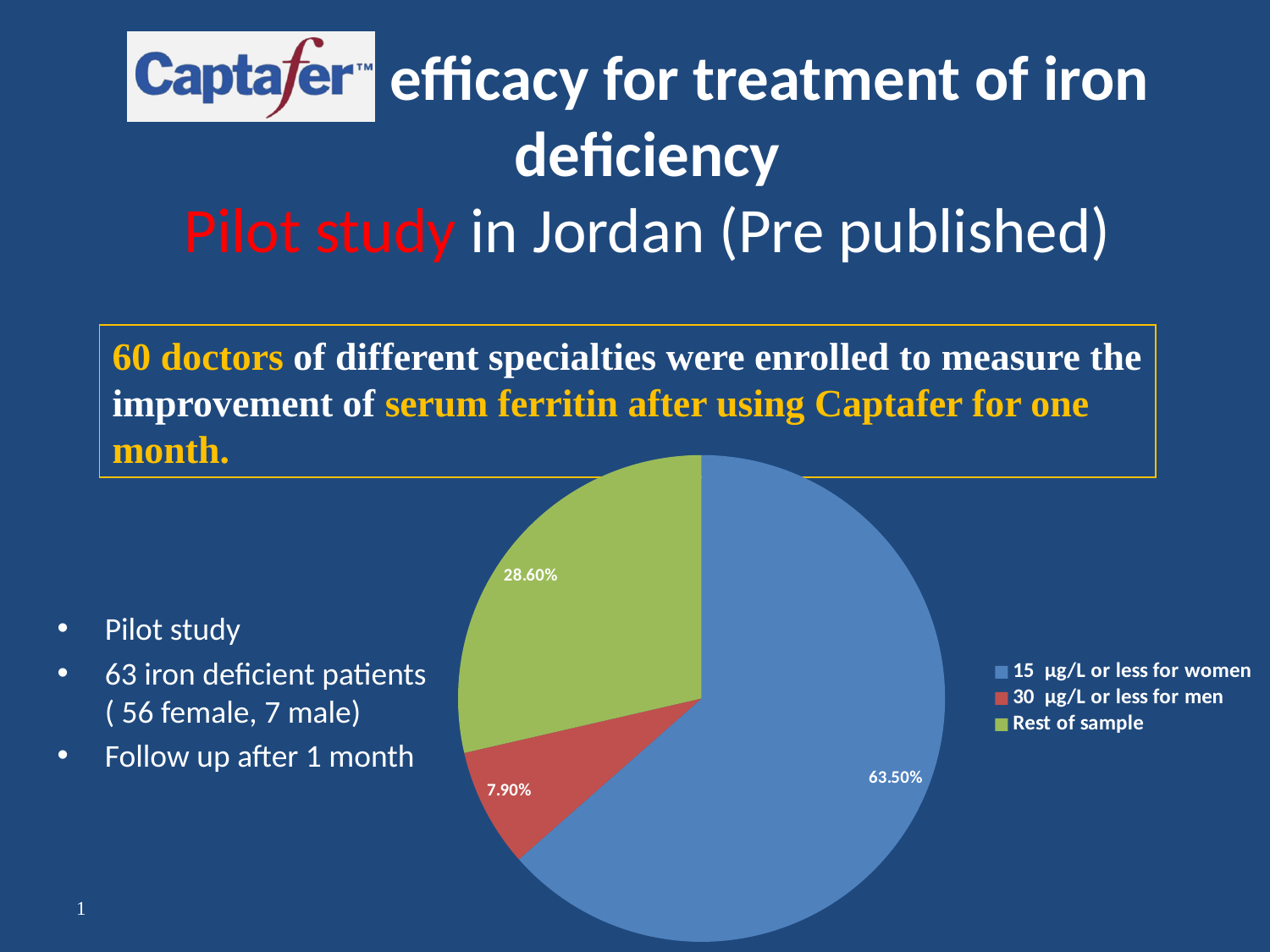
What share of the pie does the '30 µg/L or less for men' slice represent? 7.90% Which slice of the pie is the smallest? 30 µg/L or less for men How many entries does the legend list? 3 What share of the pie does the 'Rest of sample' slice represent? 28.60% What is the difference between the '15 µg/L or less for women' share and the 'Rest of sample' share? 34.90% Which slice of the pie is the largest? 15 µg/L or less for women What share of the pie does the '15 µg/L or less for women' slice represent? 63.50% What kind of chart is shown on the slide? pie chart Which is larger: the 'Rest of sample' slice or the '30 µg/L or less for men' slice? Rest of sample How many slices does the pie chart have? 3 What colour is the 'Rest of sample' slice? green What is the difference between the 'Rest of sample' share and the '30 µg/L or less for men' share? 20.70%